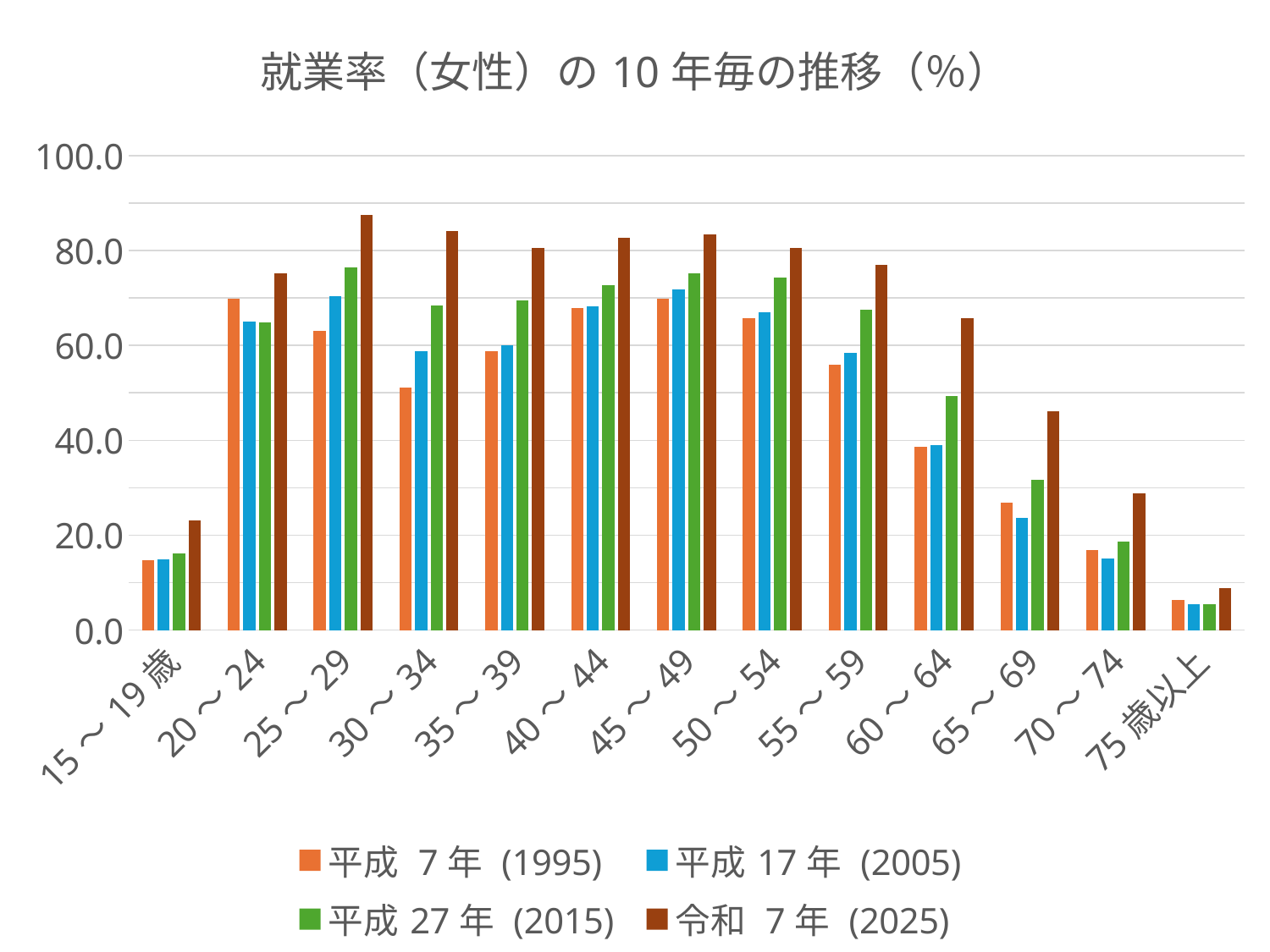
For the 令和 7 年 (2025) series, which age group has the lowest value? 75歳以上 What kind of chart is shown on the slide? bar chart How many series does the legend list? 4 For the 65～69 age group, which is larger: the 平成 7 年 (1995) value or the 平成 17 年 (2005) value? 平成 7 年 (1995) For the 令和 7 年 (2025) series, do the values rise or fall from 50～54 through 75歳以上? fall For the 令和 7 年 (2025) series, which age group has the highest value? 25～29 For the 20～24 age group, which is larger: the 平成 7 年 (1995) value or the 平成 27 年 (2015) value? 平成 7 年 (1995) What is the title of the chart? 就業率（女性）の 10 年毎の推移（%） How many age-group categories are shown on the x axis? 13 Is the 令和 7 年 (2025) value for 30～34 greater or less than 80.0? greater Is the 平成 7 年 (1995) value for 30～34 greater or less than 60.0? less Is the 平成 27 年 (2015) value for 60～64 greater or less than 40.0? greater